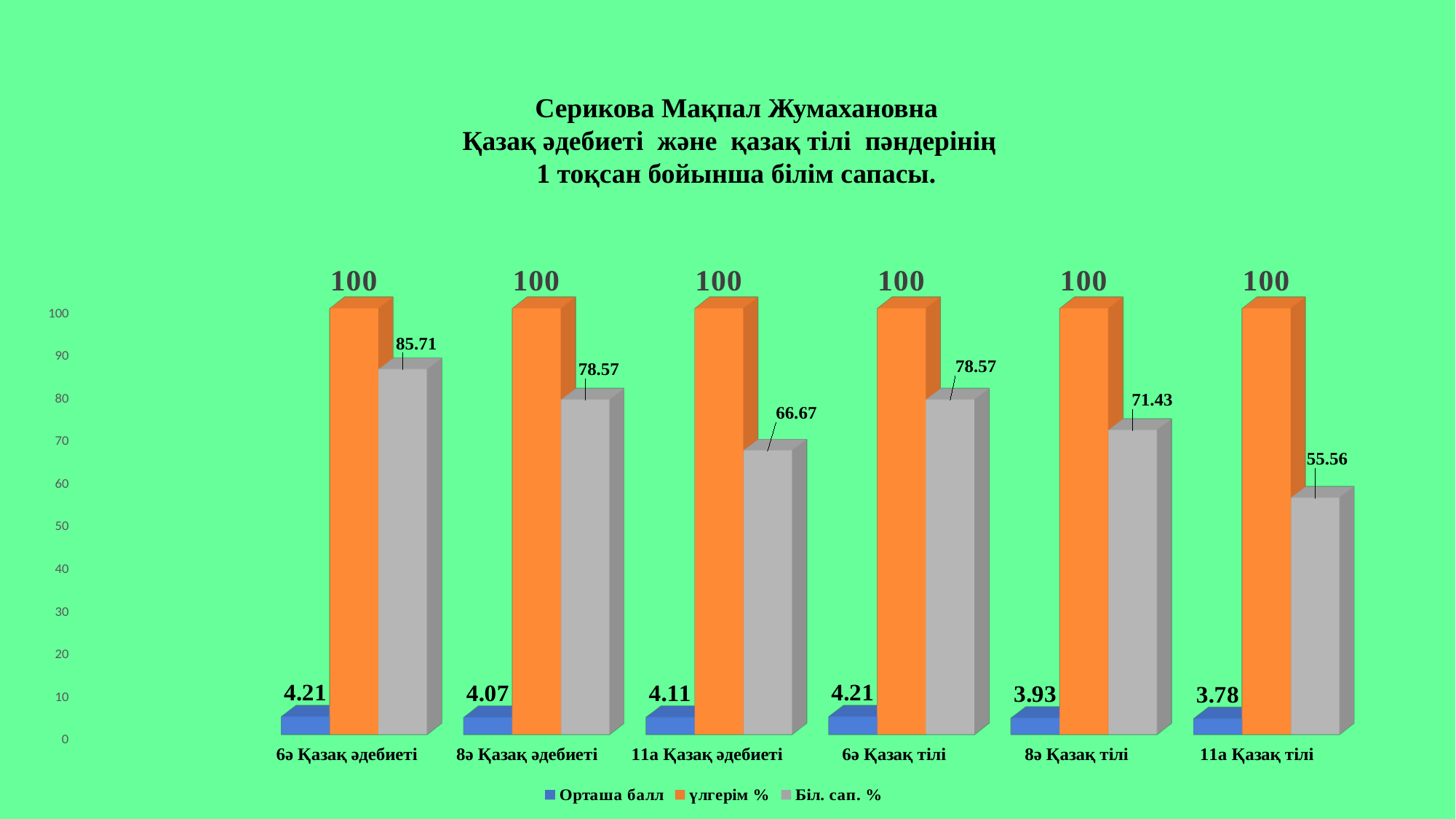
Which is larger, the Орташа балл for 8ә Қазақ әдебиеті or for 8ә Қазақ тілі? 8ә Қазақ әдебиеті How many series does the legend list? 3 How many categories are shown on the x axis? 6 What is the Орташа балл value for 11а Қазақ тілі? 3.78 Is the Біл. сап. % value for 11а Қазақ әдебиеті greater or less than 70? less Which category has the highest Біл. сап. % value? 6ә Қазақ әдебиеті What is the Біл. сап. % value for 6ә Қазақ әдебиеті? 85.71 What is the difference between the Біл. сап. % values for 6ә Қазақ әдебиеті and 11а Қазақ тілі? 30.15 What is the үлгерім % value for 8ә Қазақ тілі? 100 What kind of chart is shown on the slide? bar chart Which series is shown in orange? үлгерім % Which category has the lowest Біл. сап. % value? 11а Қазақ тілі